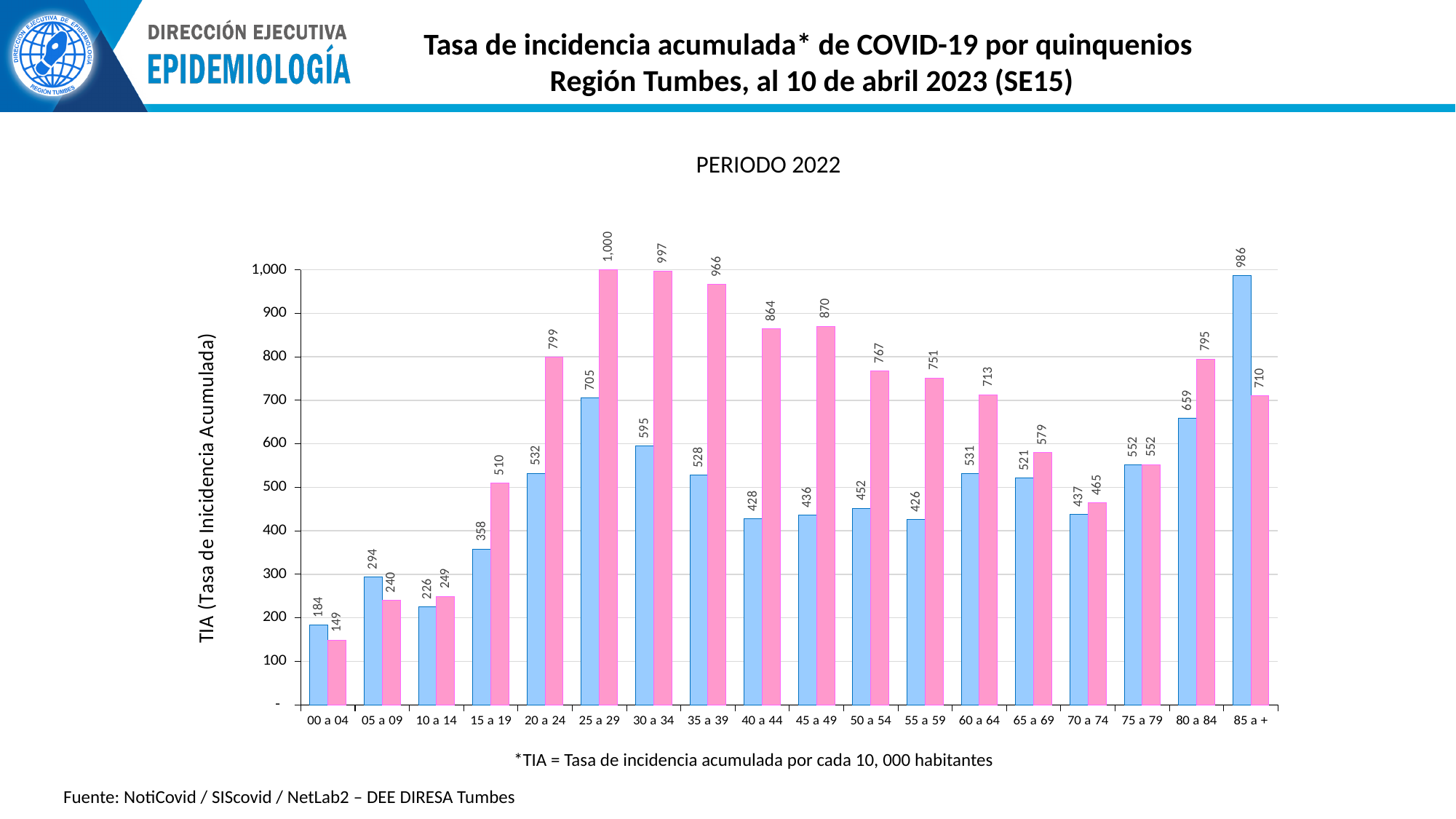
What type of chart is shown on the slide? bar chart What is the value of the blue bar for the 85 a + age group? 986 What is the difference between the blue and pink bars for the 85 a + age group? 276 What is the value of the pink bar for the 25 a 29 age group? 1,000 Which is larger for the 30 a 34 age group, the blue bar or the pink bar? the pink bar What is the difference between the pink and blue bars for the 25 a 29 age group? 295 What is the value of the pink bar for the 75 a 79 age group? 552 What is the value of the blue bar for the 40 a 44 age group? 428 What is the title shown above the chart? PERIODO 2022 How many age-group categories are shown on the x axis? 18 Which age group has the highest pink bar? 25 a 29 Which age group has the lowest blue bar? 00 a 04